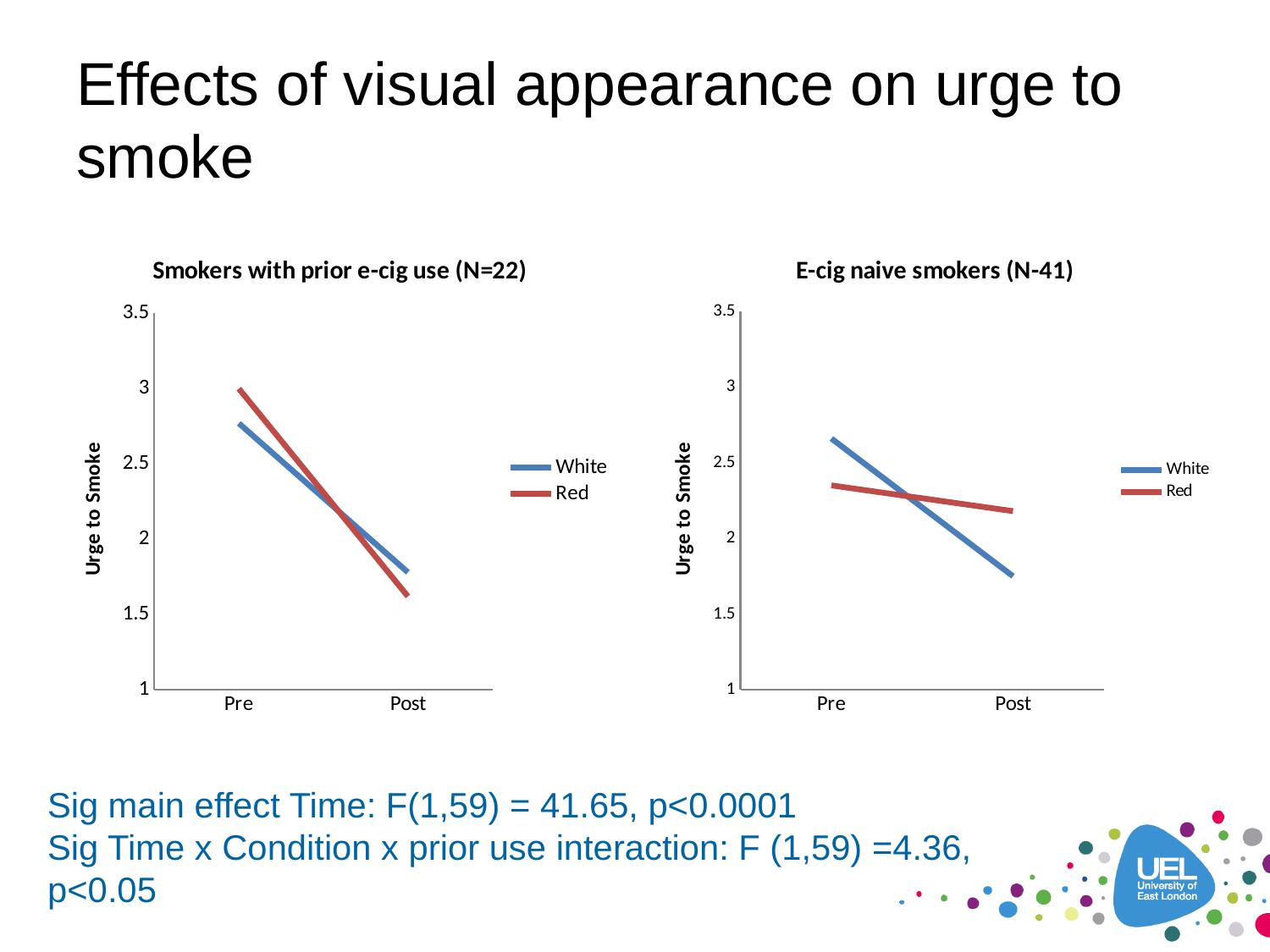
In the chart titled 'Smokers with prior e-cig use (N=22)', is the Pre value for Red greater or less than 2.5? greater In the chart titled 'E-cig naive smokers (N-41)', is the Post value for White greater or less than 2? less In the chart titled 'Smokers with prior e-cig use (N=22)', how many time points are shown on the x axis? 2 In the chart titled 'E-cig naive smokers (N-41)', which series has the higher value at Pre, White or Red? White In the chart titled 'Smokers with prior e-cig use (N=22)', is the Post value for Red greater or less than 2? less In the chart titled 'E-cig naive smokers (N-41)', does the White line rise or fall from Pre to Post? fall In the chart titled 'Smokers with prior e-cig use (N=22)', what kind of chart is shown? line chart In the chart titled 'E-cig naive smokers (N-41)', how many series does the legend list? 2 In the chart titled 'Smokers with prior e-cig use (N=22)', does the Red line rise or fall from Pre to Post? fall What is the y-axis label of the chart titled 'Smokers with prior e-cig use (N=22)'? Urge to Smoke In the chart titled 'E-cig naive smokers (N-41)', which series has the higher value at Post, White or Red? Red